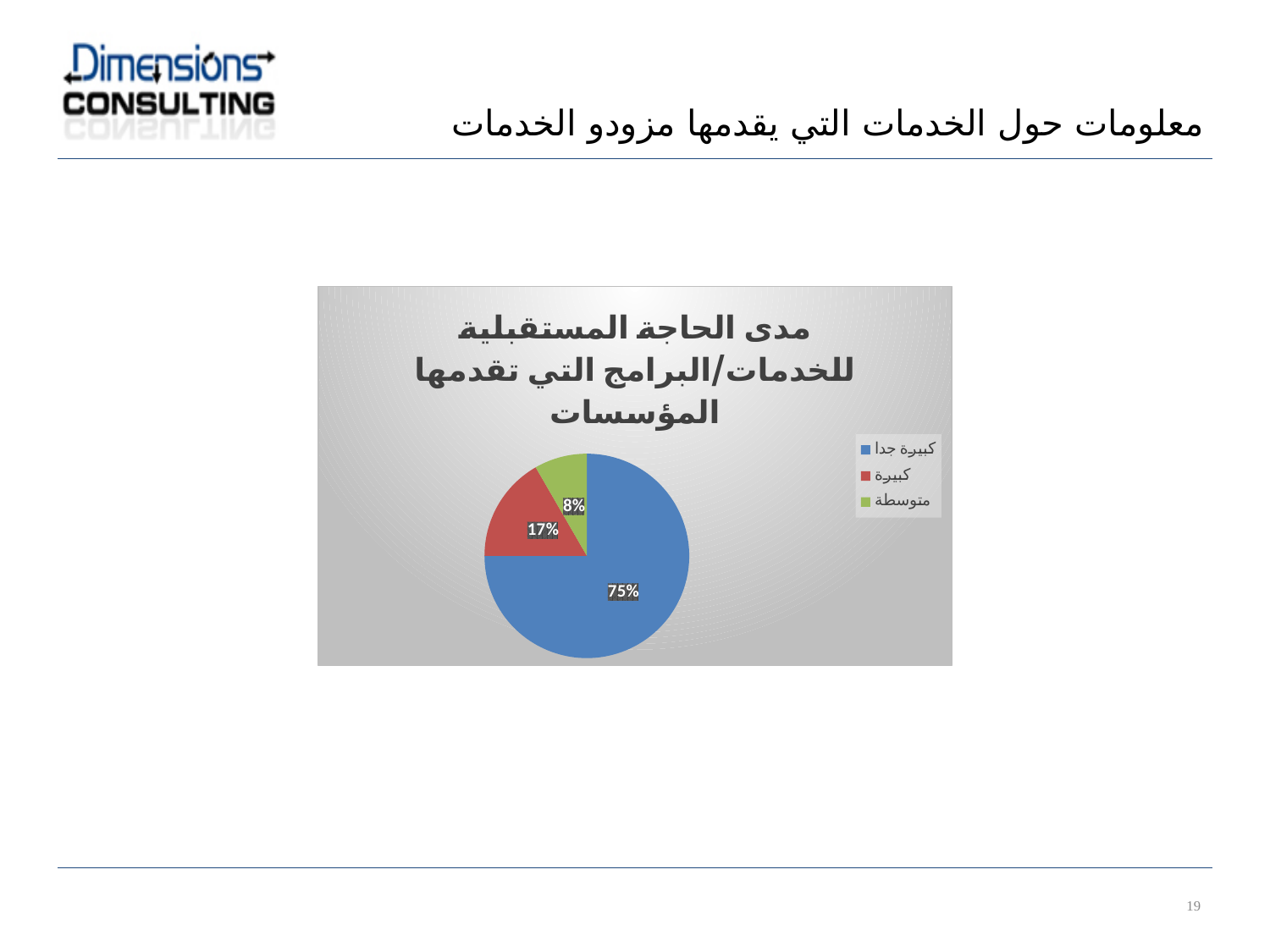
Which slice is larger, كبيرة or متوسطة? كبيرة What is the difference in percentage points between the slices for كبيرة and متوسطة? 9% How many slices does the pie chart have? 3 Which category has the largest slice of the pie? كبيرة جدا What share of the pie does the slice for كبيرة represent? 17% What colour is the slice for كبيرة جدا? blue What kind of chart is shown on the slide? pie chart What is the difference in percentage points between the slices for كبيرة جدا and كبيرة? 58% How many entries does the legend list? 3 Which category has the smallest slice of the pie? متوسطة What share of the pie does the slice for متوسطة represent? 8% What share of the pie does the slice for كبيرة جدا represent? 75%